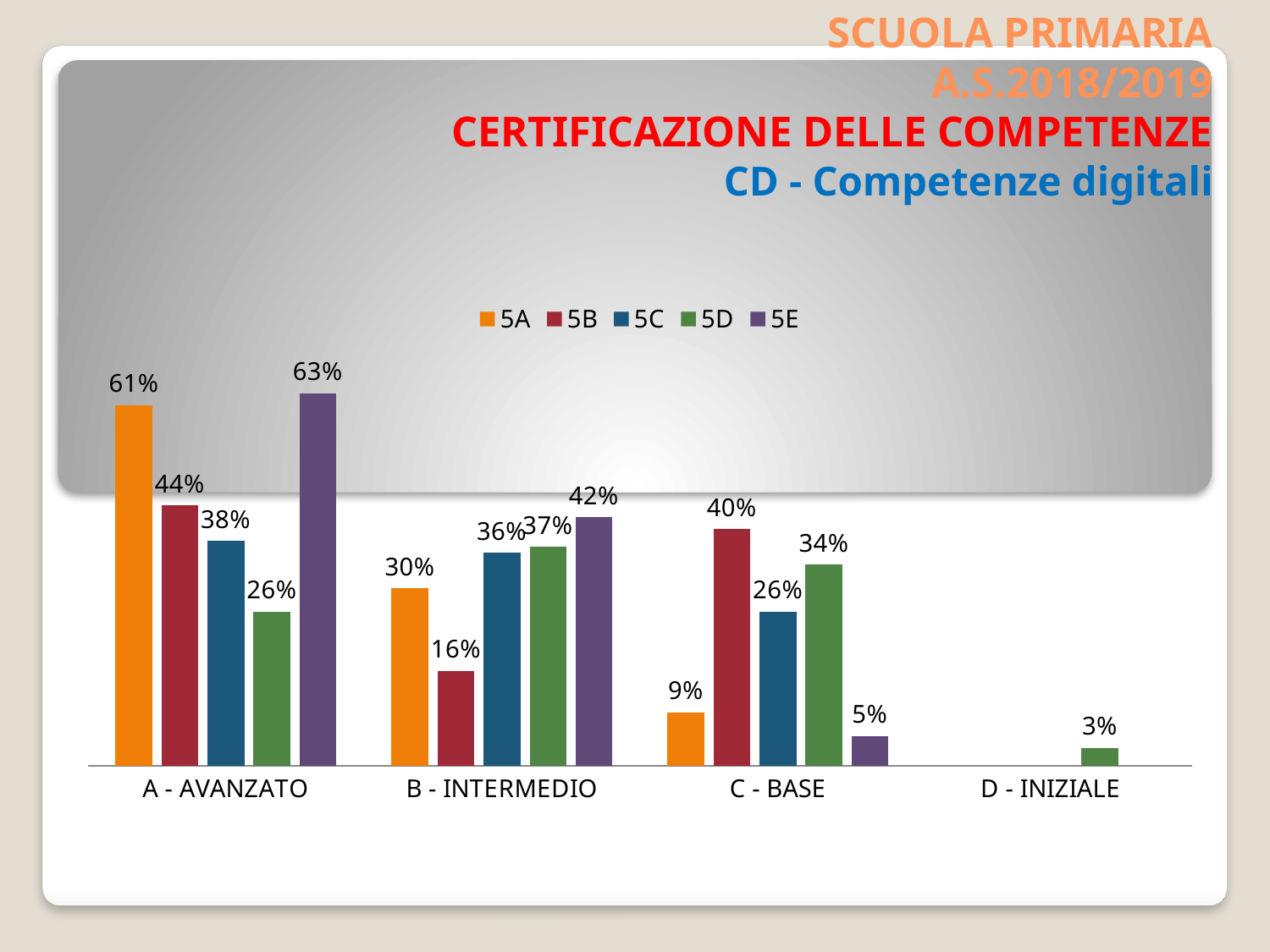
Which series has the lowest value in the C - BASE category? 5E How many categories are shown on the x axis? 4 What is the value for 5A in the A - AVANZATO category? 61% What type of chart is shown on the slide? bar chart What is the value for 5D in the D - INIZIALE category? 3% What is the difference between the 5B and 5A values in the C - BASE category? 31% Which series is shown in orange in the legend? 5A What is the value for 5E in the B - INTERMEDIO category? 42% Which series has the highest value in the A - AVANZATO category? 5E What is the difference between the 5E and 5D values in the A - AVANZATO category? 37% How many series does the legend list? 5 In the B - INTERMEDIO category, which is larger, the value for 5A or the value for 5B? 5A